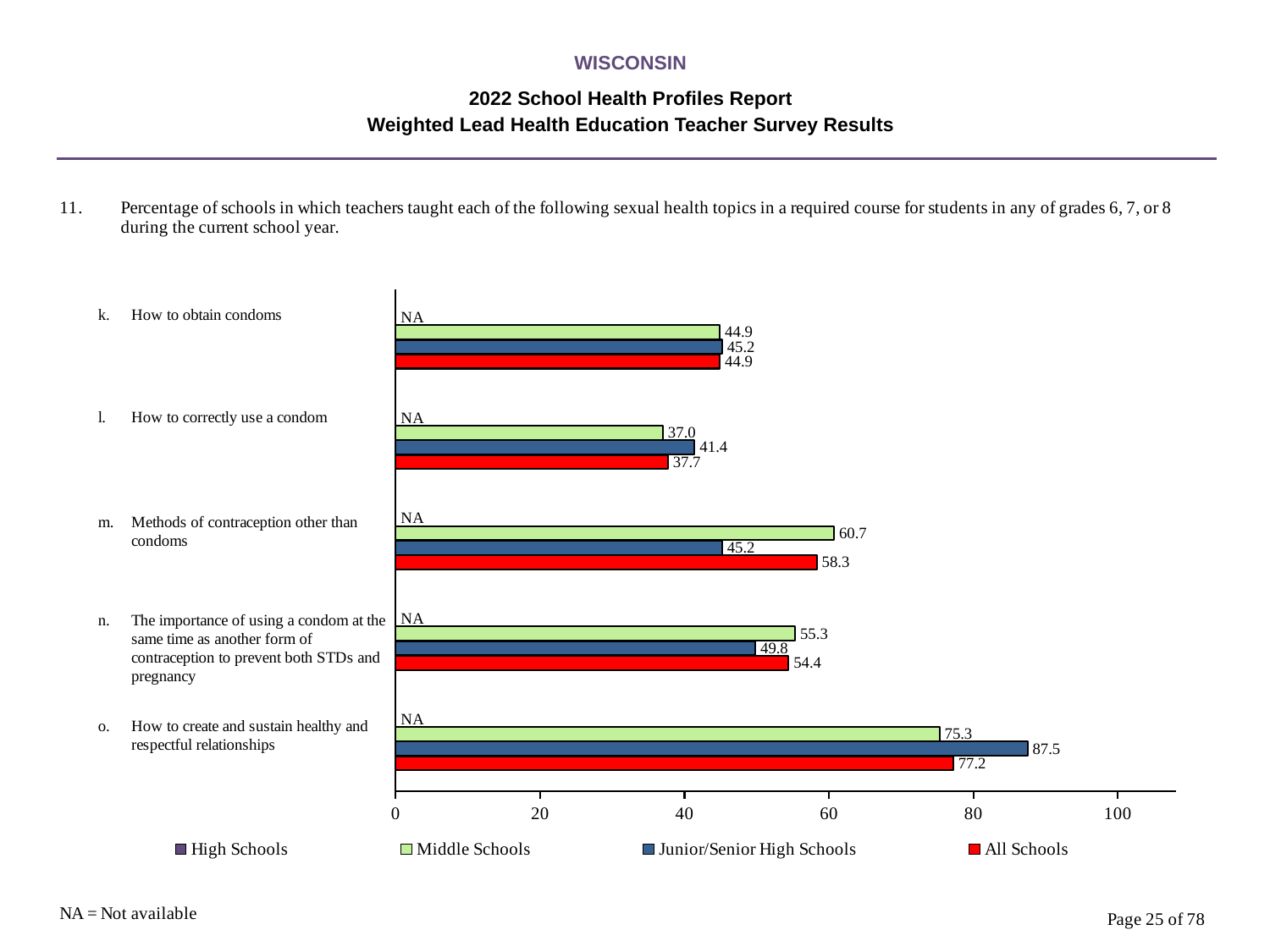
How many topics (categories) are shown on the chart? 5 What kind of chart is shown on the slide? Bar chart What is the value for Middle Schools for 'How to obtain condoms'? 44.9 What is the value for Junior/Senior High Schools for 'How to create and sustain healthy and respectful relationships'? 87.5 What is the value for All Schools for 'Methods of contraception other than condoms'? 58.3 Which topic has the highest value for All Schools? How to create and sustain healthy and respectful relationships For 'The importance of using a condom at the same time as another form of contraception to prevent both STDs and pregnancy', which is larger: Middle Schools or Junior/Senior High Schools? Middle Schools What is the difference between the Middle Schools and Junior/Senior High Schools values for 'Methods of contraception other than condoms'? 15.5 What value is shown for High Schools for every topic on the chart? NA What is the value for Junior/Senior High Schools for 'How to correctly use a condom'? 41.4 Which topic has the lowest value for Middle Schools? How to correctly use a condom How many series does the legend list? 4